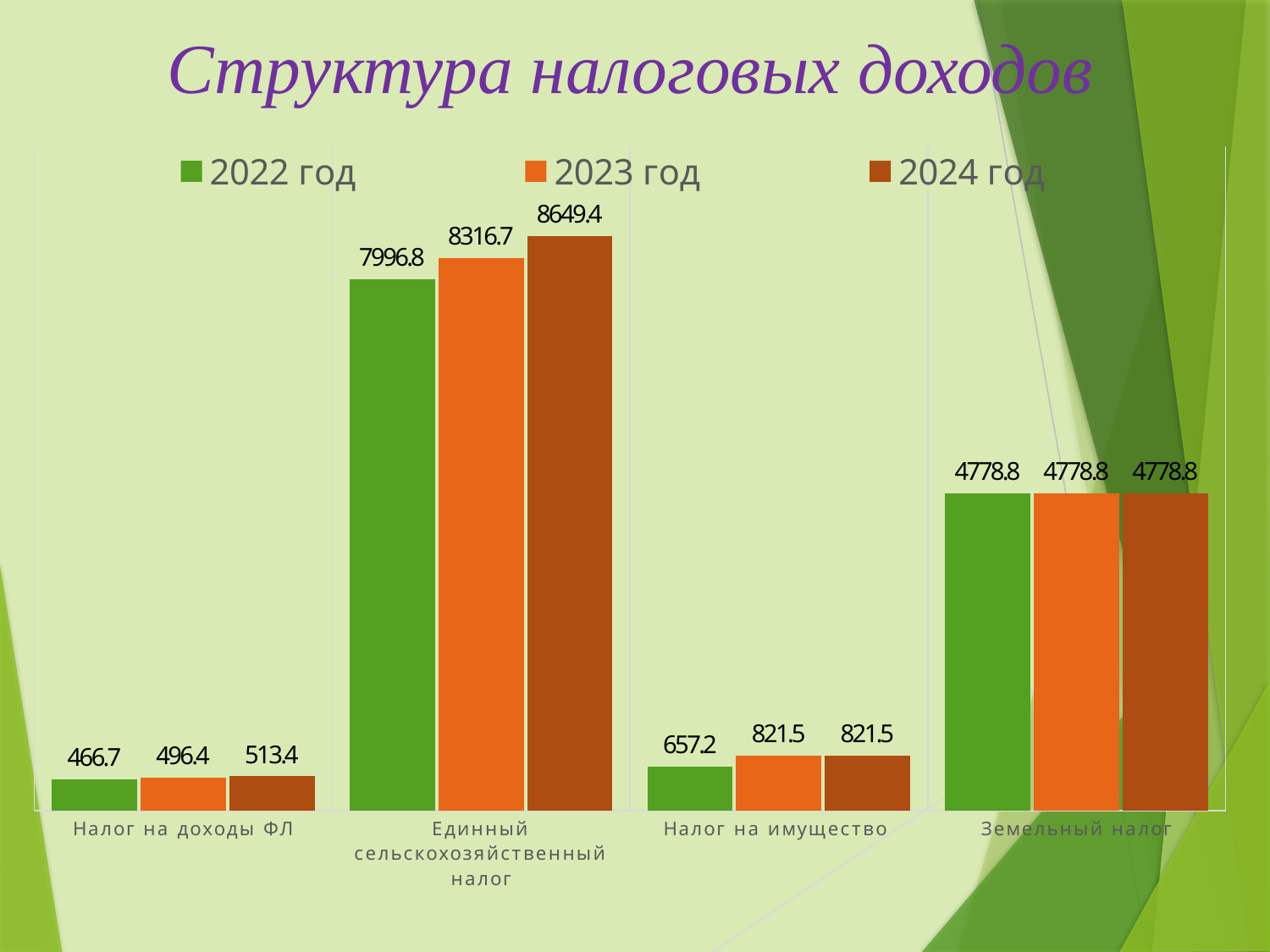
What is the value for Земельный налог in 2024 год? 4778.8 Which is larger for Налог на имущество: the 2022 год value or the 2023 год value? 2023 год What is the value for Налог на имущество in 2023 год? 821.5 What is the difference between the 2024 год and 2022 год values for Единый сельскохозяйственный налог? 652.6 What is the value for Налог на доходы ФЛ in 2022 год? 466.7 Which category has the lowest value in 2024 год? Налог на доходы ФЛ How many categories are shown on the x axis? 4 What is the title of the chart? Структура налоговых доходов What kind of chart is shown on the slide? bar chart Which category has the highest value in 2022 год? Единый сельскохозяйственный налог How many series does the legend list? 3 What is the value for Единый сельскохозяйственный налог in 2024 год? 8649.4